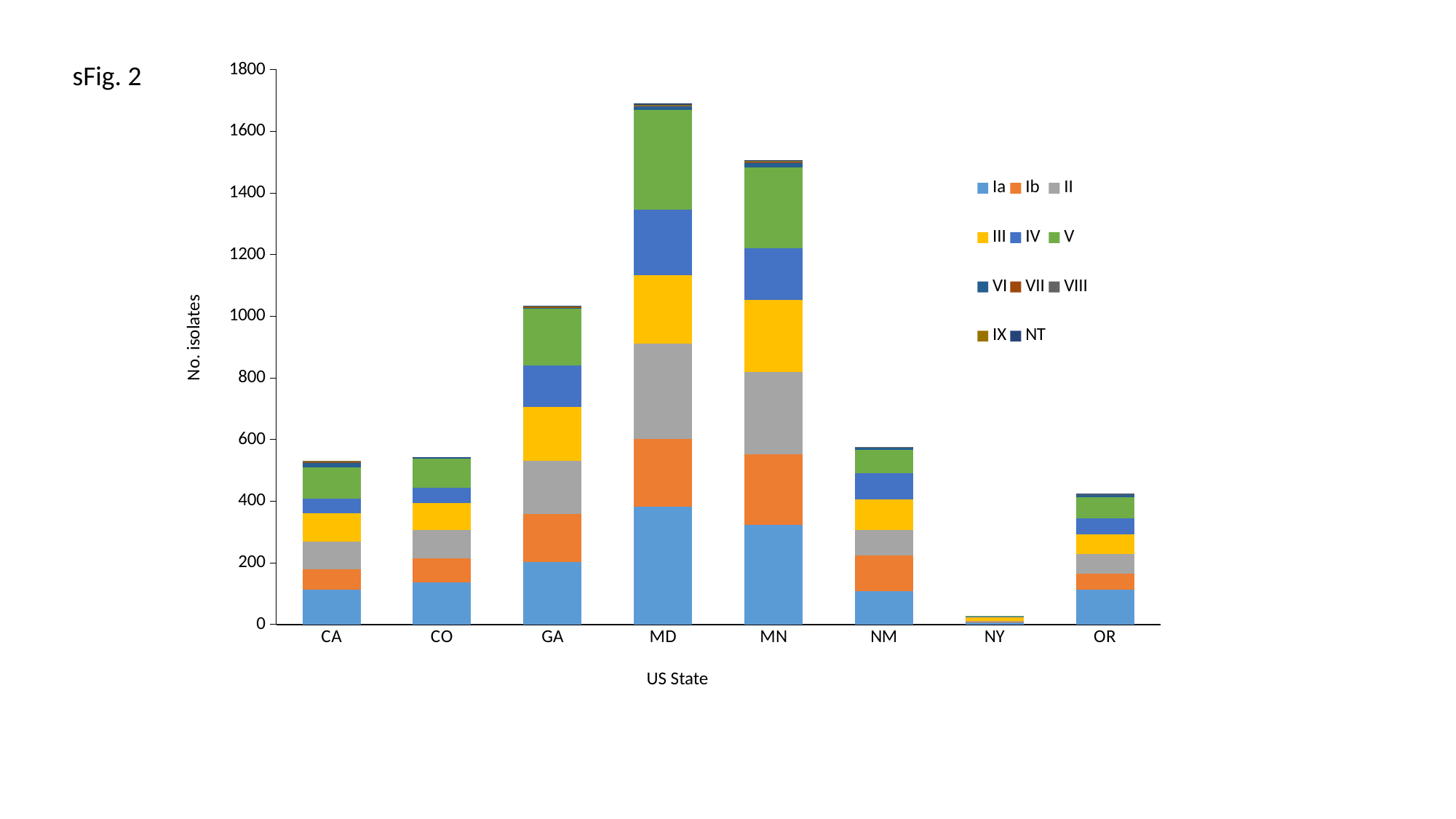
Which state has a larger total number of isolates, GA or CO? GA Is the total number of isolates for NY greater or less than 200? less How many series does the chart's legend list? 11 Which state has the lowest total number of isolates? NY Is the total number of isolates for OR greater or less than 600? less Which state has a larger total number of isolates, MN or NM? MN What is the title of the y axis of the chart? No. isolates Is the total number of isolates for MD greater or less than 1600? greater Which state has the highest total number of isolates? MD How many US states are shown on the x axis of the chart? 8 What is the title of the x axis of the chart? US State What kind of chart is shown on the slide? stacked bar chart